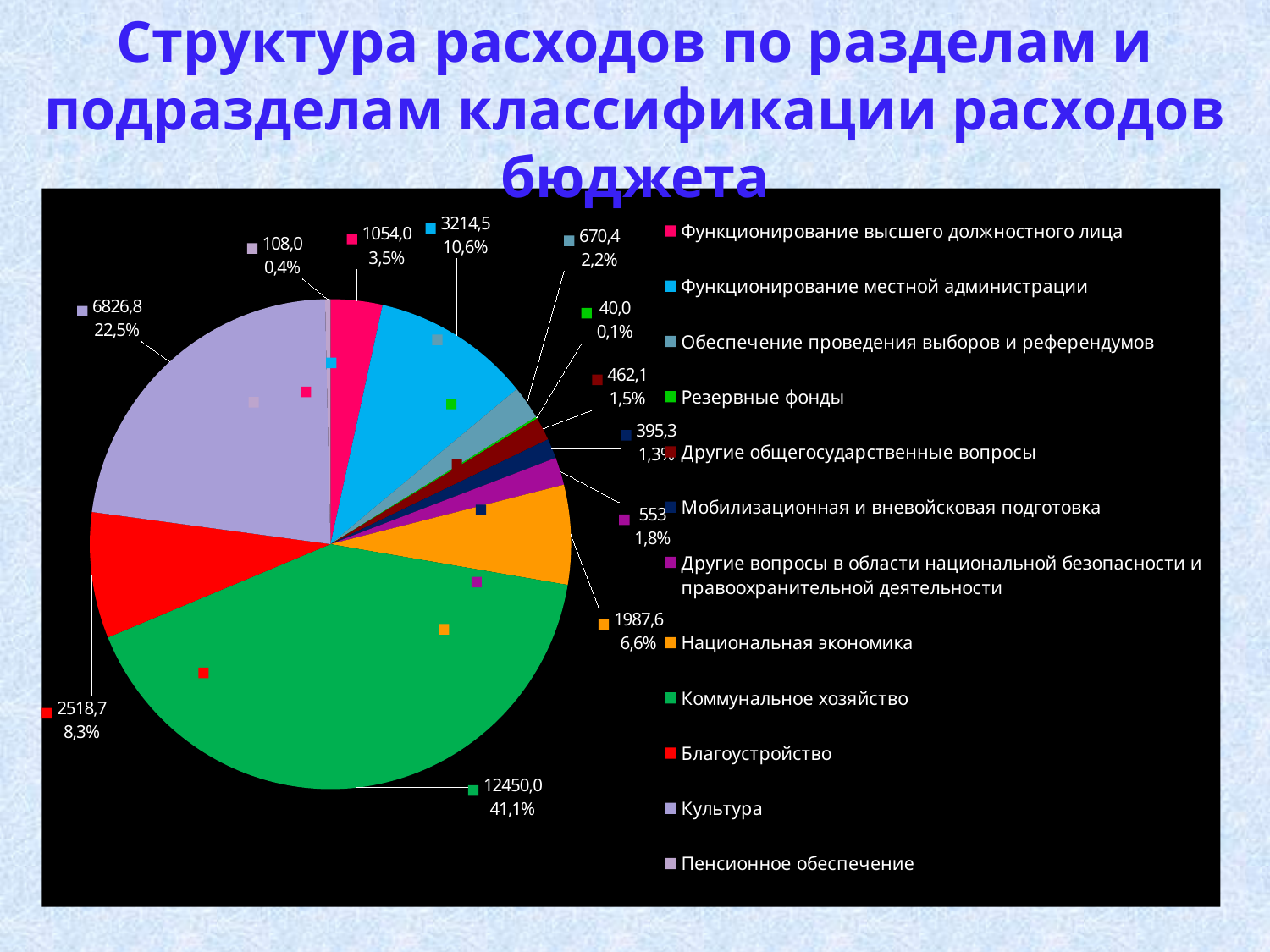
Which category has the largest slice of the pie? Коммунальное хозяйство Which is larger, the value for Благоустройство or the value for Национальная экономика? Благоустройство What is the value shown for Национальная экономика? 1987,6 What is the difference between the values for Культура and Благоустройство? 4308,1 What share of the pie does Культура account for? 22,5% What is the title of the chart on the slide? Структура расходов по разделам и подразделам классификации расходов бюджета How many categories does the legend of the pie chart list? 12 What kind of chart is shown on the slide? pie chart Which category has the smallest slice of the pie? Резервные фонды What is the value shown for Функционирование местной администрации? 3214,5 What is the value shown for Коммунальное хозяйство? 12450,0 What share of the pie does Благоустройство account for? 8,3%